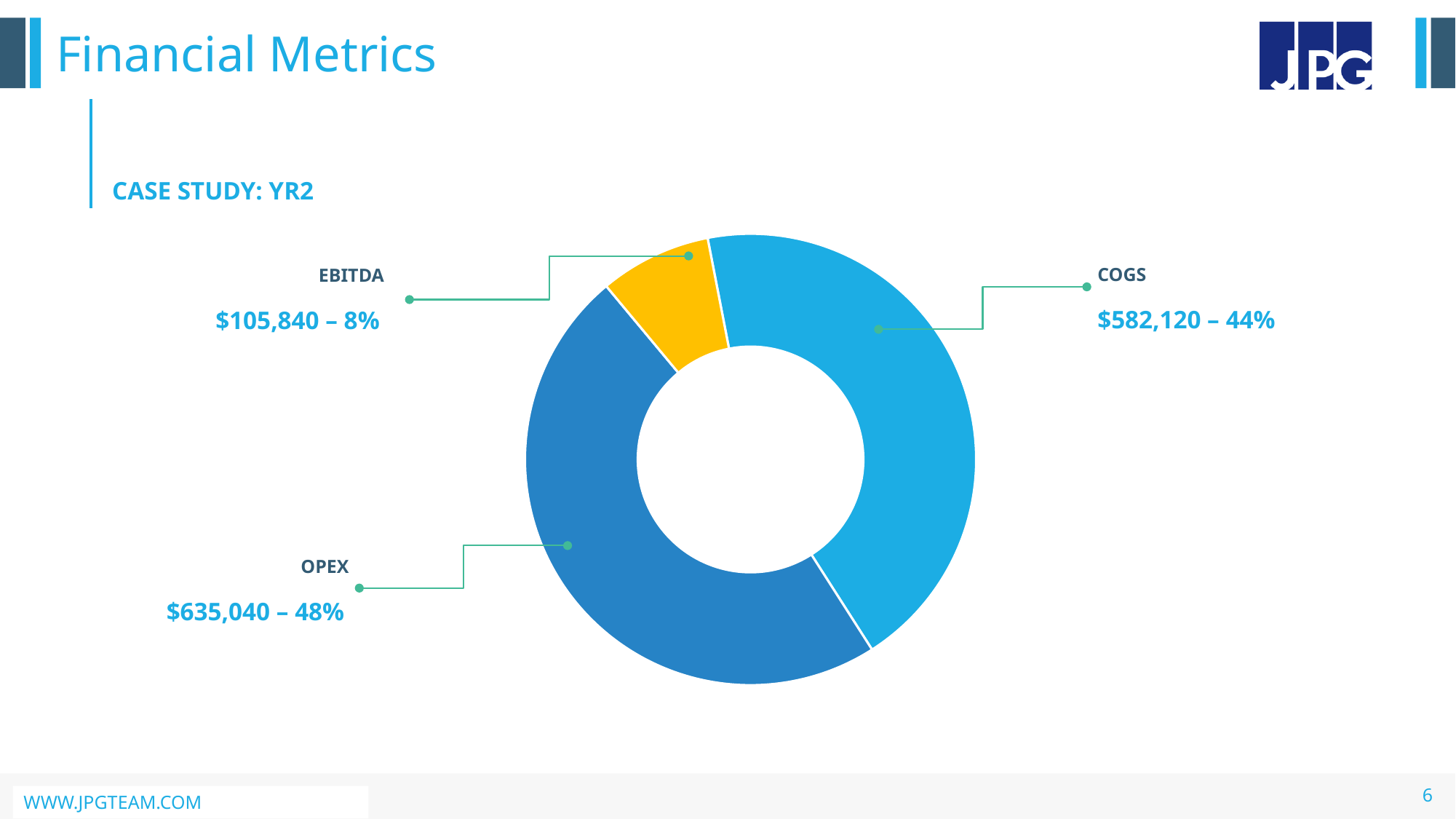
What percentage share of the donut chart does EBITDA represent? 8% How many categories are shown in the donut chart? 3 What is the value shown for EBITDA in the donut chart? $105,840 What is the value shown for OPEX in the donut chart? $635,040 What type of chart is shown on the slide? Donut (pie) chart What is the value shown for COGS in the donut chart? $582,120 Which category has the largest slice in the donut chart? OPEX Which is larger, the value for COGS or the value for EBITDA? COGS What is the difference between the COGS and EBITDA values? $476,280 Which category has the smallest slice in the donut chart? EBITDA What is the difference between the OPEX and COGS values? $52,920 What percentage share of the donut chart does COGS represent? 44%